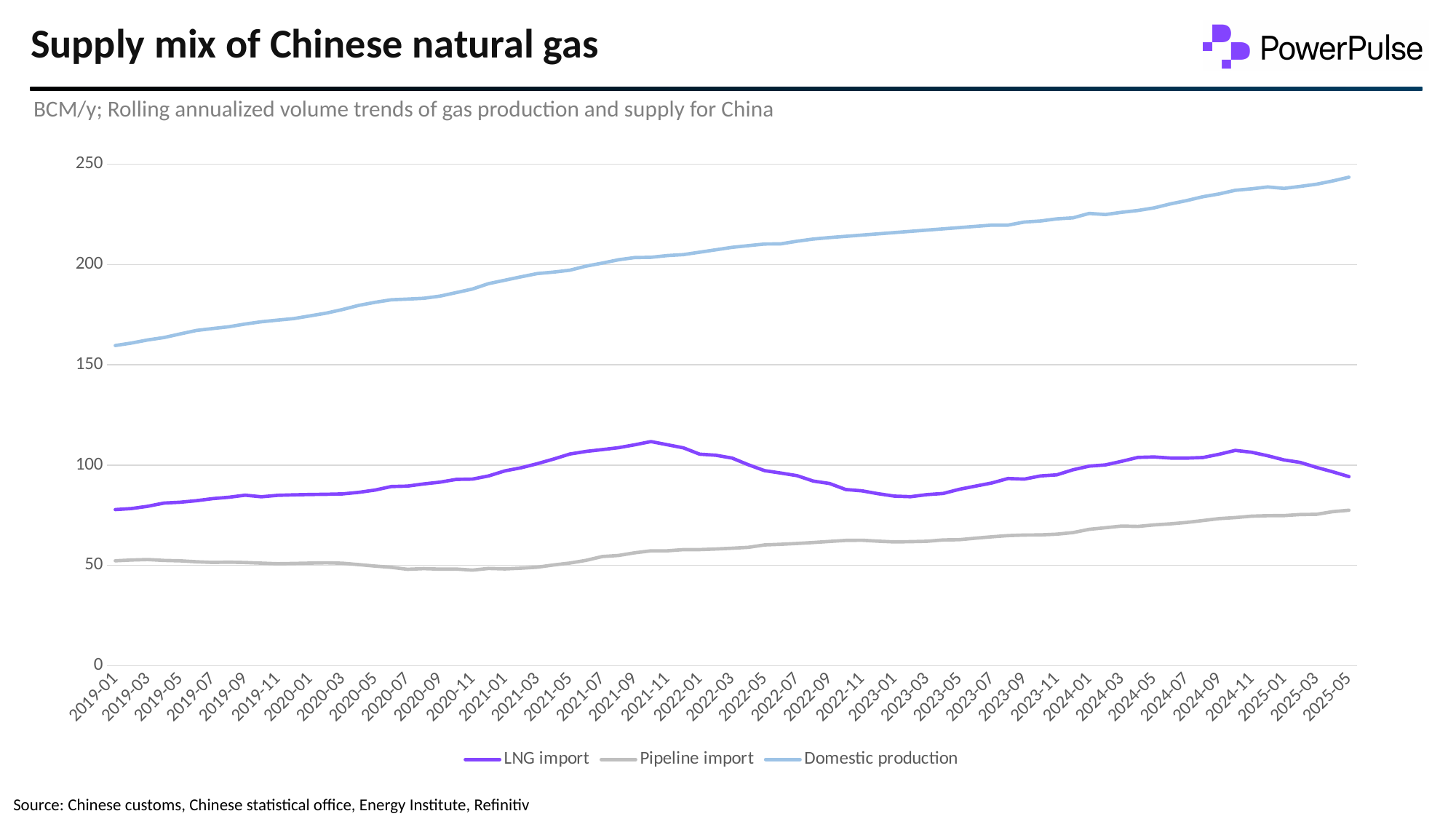
Does Domestic production rise or fall from 2019-01 to 2025-05? rise What kind of chart is shown on the slide? Line chart At 2025-05, which is larger: LNG import or Pipeline import? LNG import Is the value for LNG import at 2021-11 greater or less than 100? greater Is the value for Pipeline import at 2025-05 greater or less than 100? less Is the value for LNG import at 2023-03 greater or less than 100? less How many series does the legend list? 3 Which series has the highest values across the whole period? Domestic production What unit is the chart measured in, according to the subtitle? BCM/y Which series has the lowest values across the whole period? Pipeline import